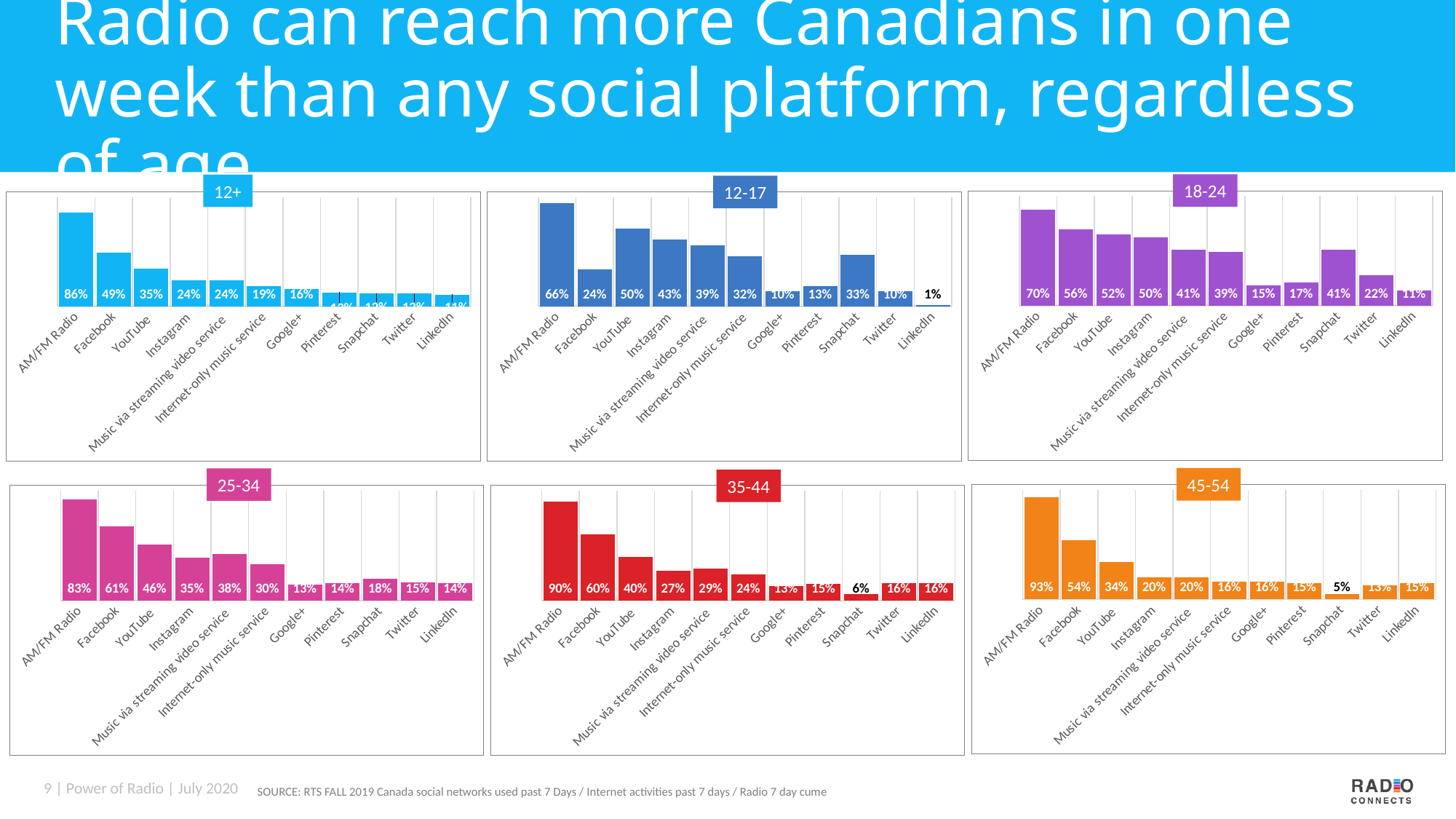
In the 35-44 chart, which category has the highest value? AM/FM Radio How many categories are shown in the 18-24 chart? 11 In the 18-24 chart, what is the value for Snapchat? 41% How many charts are on the slide? 6 In the 45-54 chart, which category has the lowest value? Snapchat In the 12-17 chart, what is the value for YouTube? 50% In the 45-54 chart, what is the value for Facebook? 54% In the 25-34 chart, what is the difference between AM/FM Radio and Facebook? 22% In the 12-17 chart, which is larger, Instagram or Snapchat? Instagram In the 12+ chart, what is the value for AM/FM Radio? 86% What kind of chart is the 25-34 chart? Bar chart In the 12-17 chart, what is the value for LinkedIn? 1%